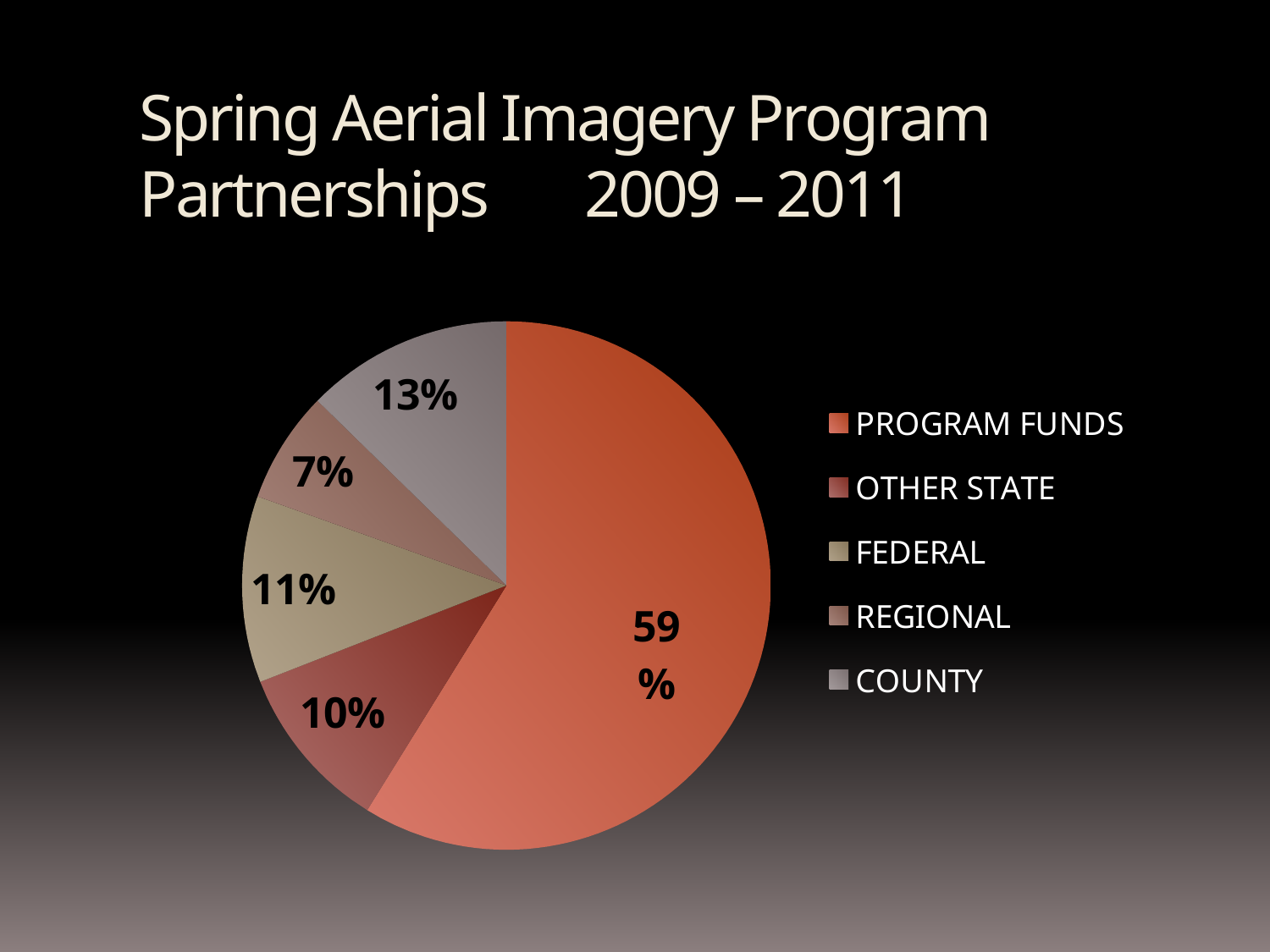
Which category has the largest slice of the pie? PROGRAM FUNDS What is the title of the slide containing the chart? Spring Aerial Imagery Program Partnerships 2009 – 2011 What is the difference in percentage points between PROGRAM FUNDS and COUNTY? 46 Which category has the smallest slice of the pie? REGIONAL What share of the pie does REGIONAL represent? 7% How many categories does the pie chart show? 5 What share of the pie does PROGRAM FUNDS represent? 59% Which is larger, the COUNTY slice or the FEDERAL slice? COUNTY What share of the pie does FEDERAL represent? 11% What kind of chart is shown on the slide? pie chart